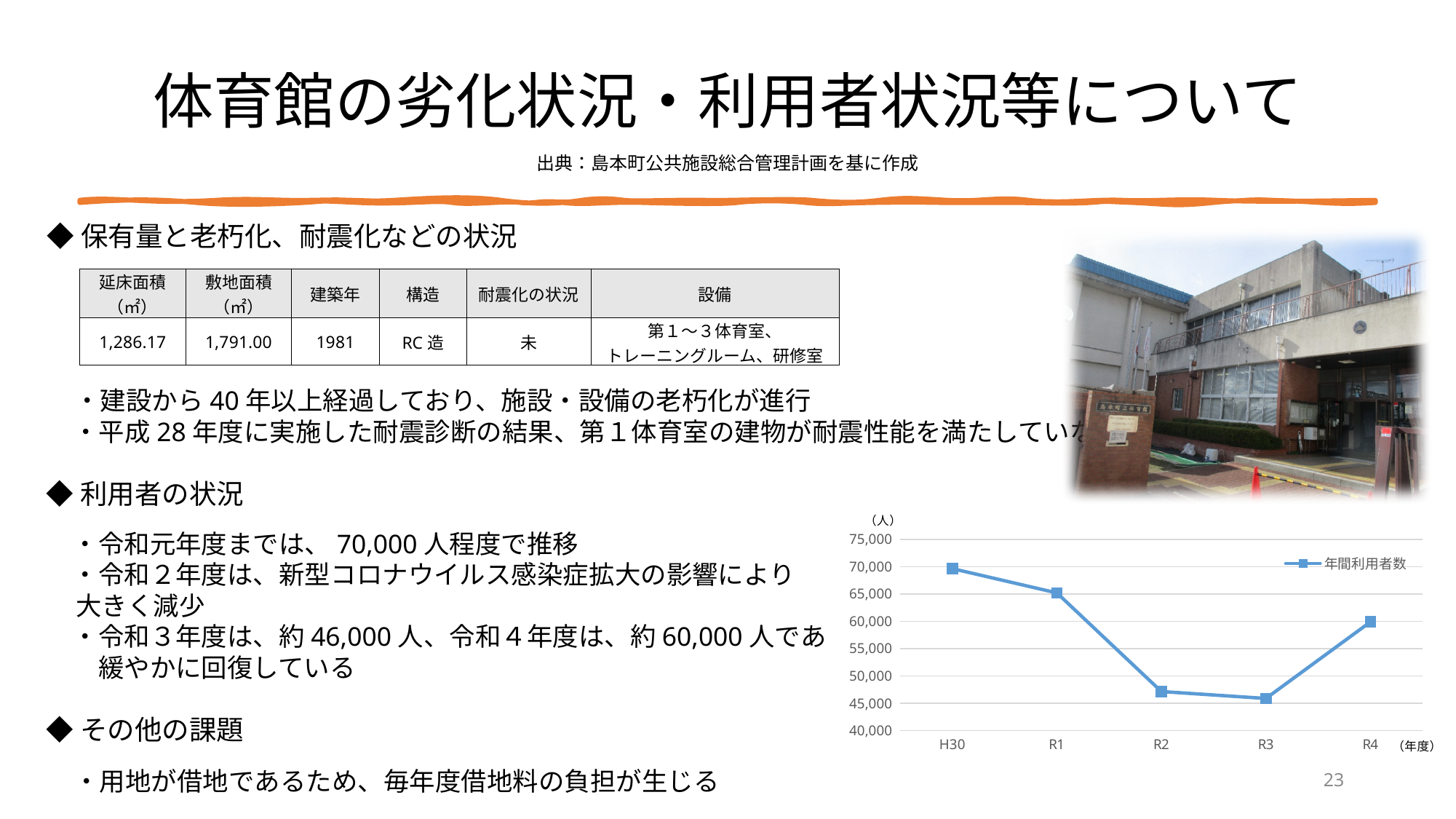
What kind of chart is shown on the slide? line chart Is the value for H30 greater or less than 65,000? greater Is the value for R2 greater or less than 50,000? less How many points (fiscal years) are plotted on the x axis of the chart? 5 What is the name of the series shown in the chart's legend? 年間利用者数 Do the values rise or fall from H30 to R3? fall Which is larger, the value for H30 or the value for R4? H30 What unit label is shown at the top of the chart's y axis? （人） Is the value for R4 greater or less than 55,000? greater How many series does the chart's legend list? 1 Which fiscal year has the highest value in the chart? H30